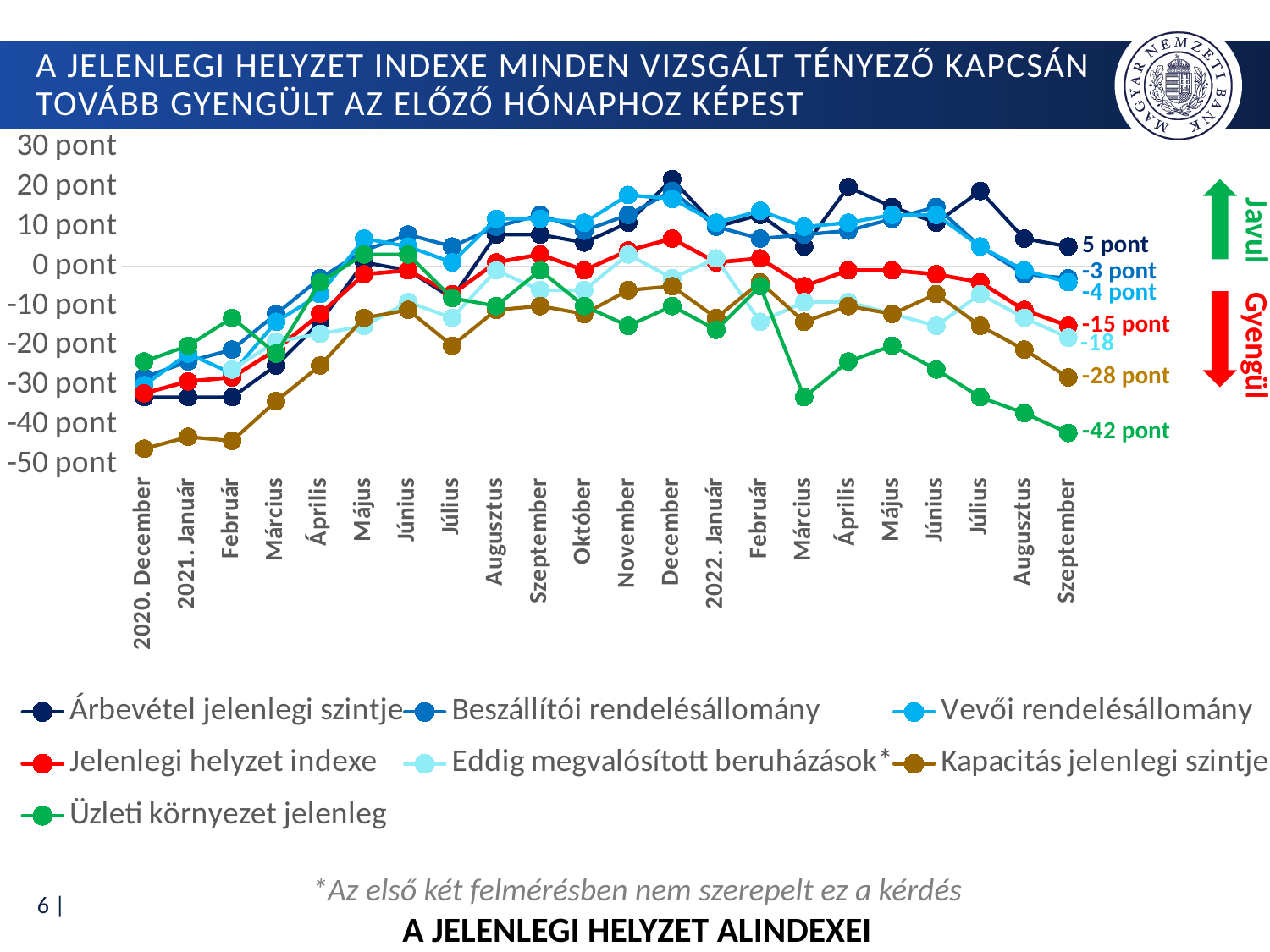
What kind of chart is shown on the slide? line chart What is the difference between Árbevétel jelenlegi szintje and Üzleti környezet jelenleg in Szeptember 2022? 47 pont Which series has the lowest value in Szeptember 2022? Üzleti környezet jelenleg What is the value of Kapacitás jelenlegi szintje in Szeptember 2022? -28 pont How many series does the legend list? 7 How many months are shown along the x axis? 22 What is the value of Üzleti környezet jelenleg in Szeptember 2022? -42 pont What is the value of Árbevétel jelenlegi szintje in Szeptember 2022? 5 pont Which series has the highest value in Szeptember 2022? Árbevétel jelenlegi szintje Does the Üzleti környezet jelenleg series rise or fall from Május 2022 to Szeptember 2022? fall Is the value of Kapacitás jelenlegi szintje in 2020 December greater or less than -40 pont? less What is the value of Jelenlegi helyzet indexe in Szeptember 2022? -15 pont